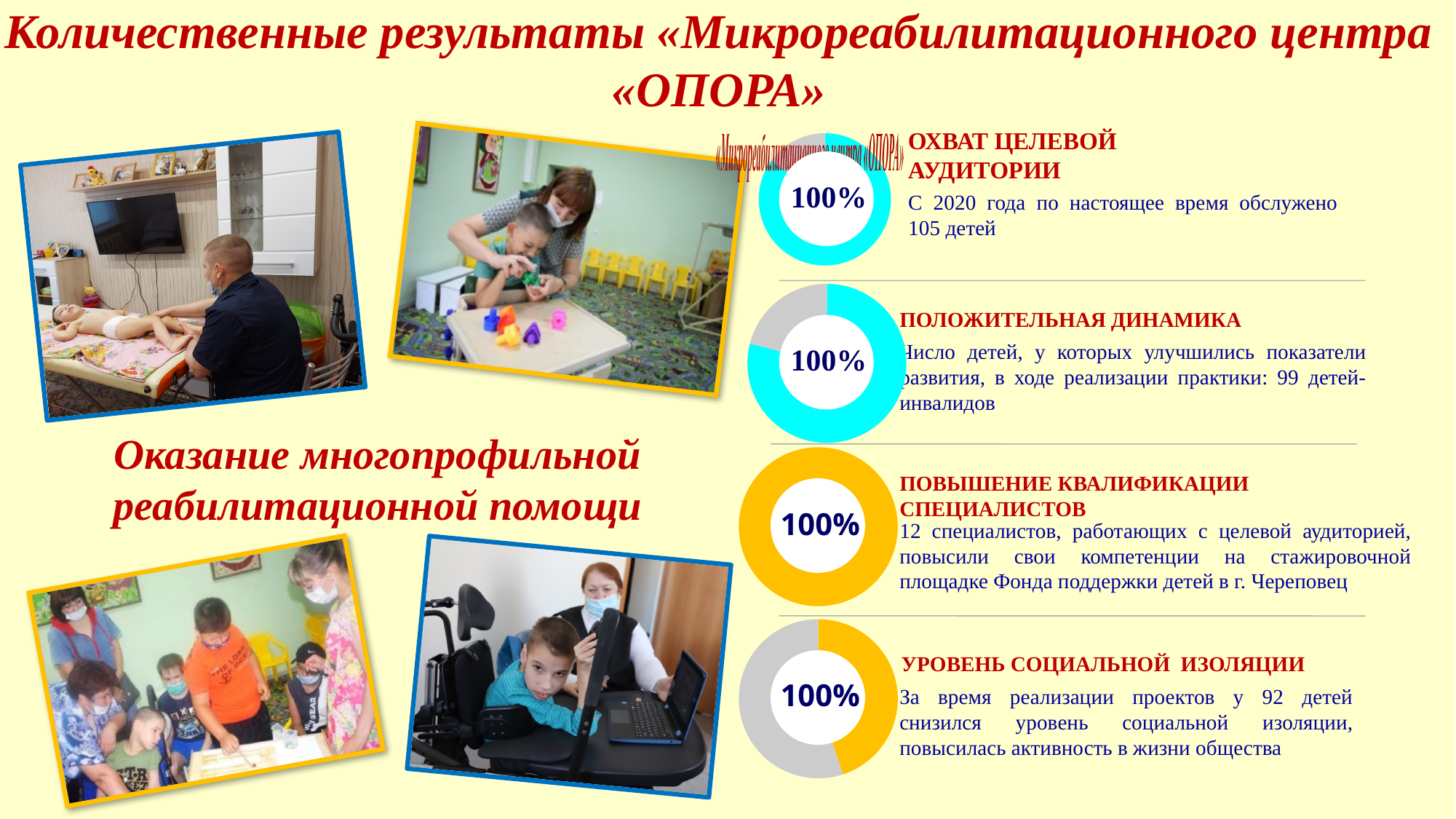
What value is printed in the centre of the chart next to "ПОВЫШЕНИЕ КВАЛИФИКАЦИИ СПЕЦИАЛИСТОВ"? 100% What value is printed in the centre of the chart next to "УРОВЕНЬ СОЦИАЛЬНОЙ ИЗОЛЯЦИИ"? 100% What value is printed in the centre of the chart next to "ПОЛОЖИТЕЛЬНАЯ ДИНАМИКА"? 100% Is the value printed in the top chart ("ОХВАТ ЦЕЛЕВОЙ АУДИТОРИИ") larger than, smaller than, or the same as the value printed in the bottom chart ("УРОВЕНЬ СОЦИАЛЬНОЙ ИЗОЛЯЦИИ")? the same What kind of chart is placed next to the heading "ОХВАТ ЦЕЛЕВОЙ АУДИТОРИИ"? doughnut chart What value is printed in the centre of the chart next to "ОХВАТ ЦЕЛЕВОЙ АУДИТОРИИ"? 100% What colour is the ring of the chart next to "ПОВЫШЕНИЕ КВАЛИФИКАЦИИ СПЕЦИАЛИСТОВ"? yellow What colour is the ring of the top chart next to "ОХВАТ ЦЕЛЕВОЙ АУДИТОРИИ"? cyan How many doughnut charts are shown on the right side of the slide? 4